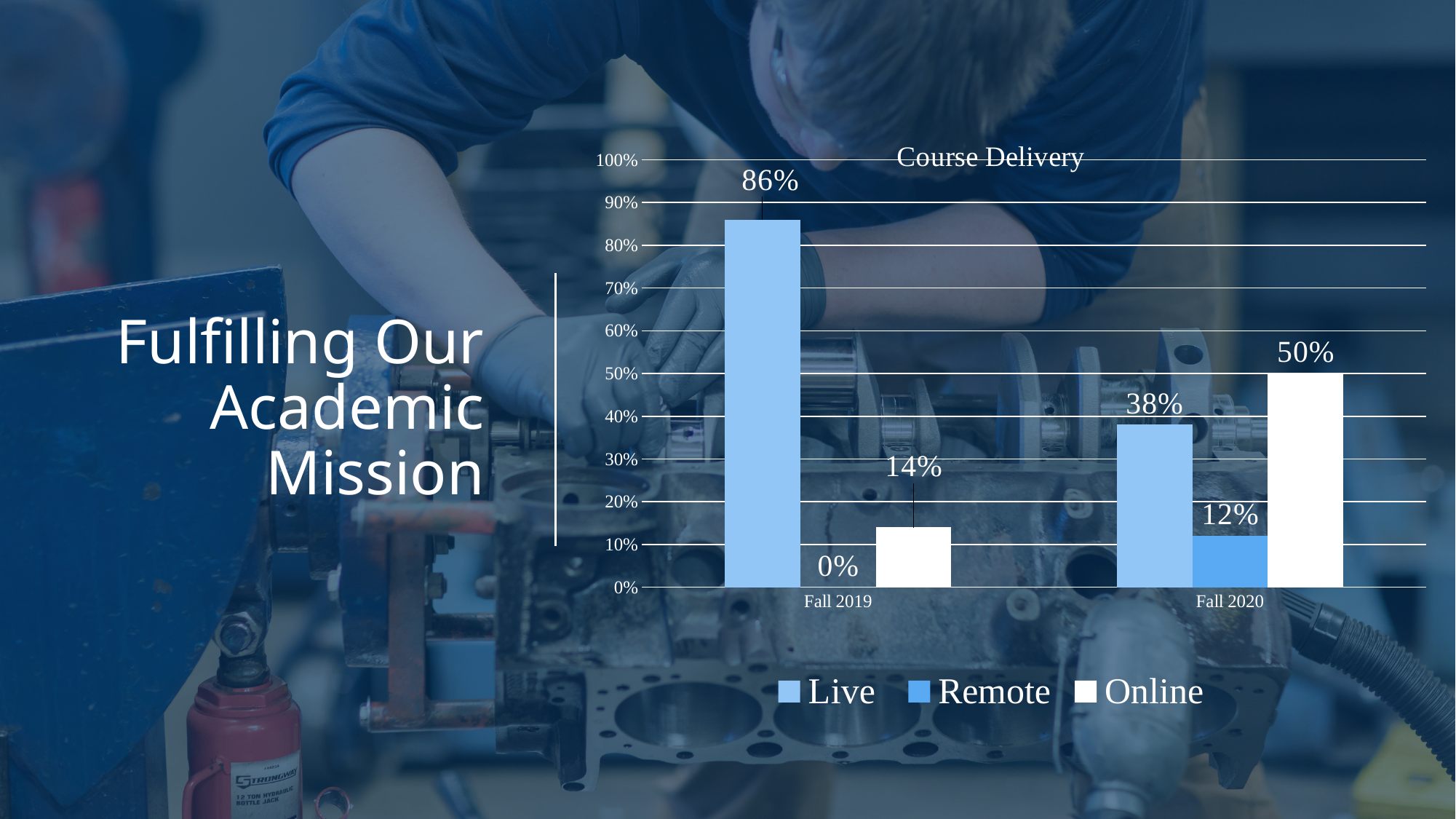
What is the value for Remote in Fall 2019? 0% What is the title of the chart? Course Delivery How many series does the legend list? 3 How many categories are shown on the x axis? 2 What is the difference between the Live value in Fall 2019 and the Live value in Fall 2020? 48% What is the value for Remote in Fall 2020? 12% Which is larger: Online in Fall 2019 or Online in Fall 2020? Online in Fall 2020 Which series has the lowest value in Fall 2019? Remote What is the value for Online in Fall 2020? 50% Which series has the highest value in Fall 2020? Online What kind of chart is shown? Bar chart What is the value for Live in Fall 2019? 86%